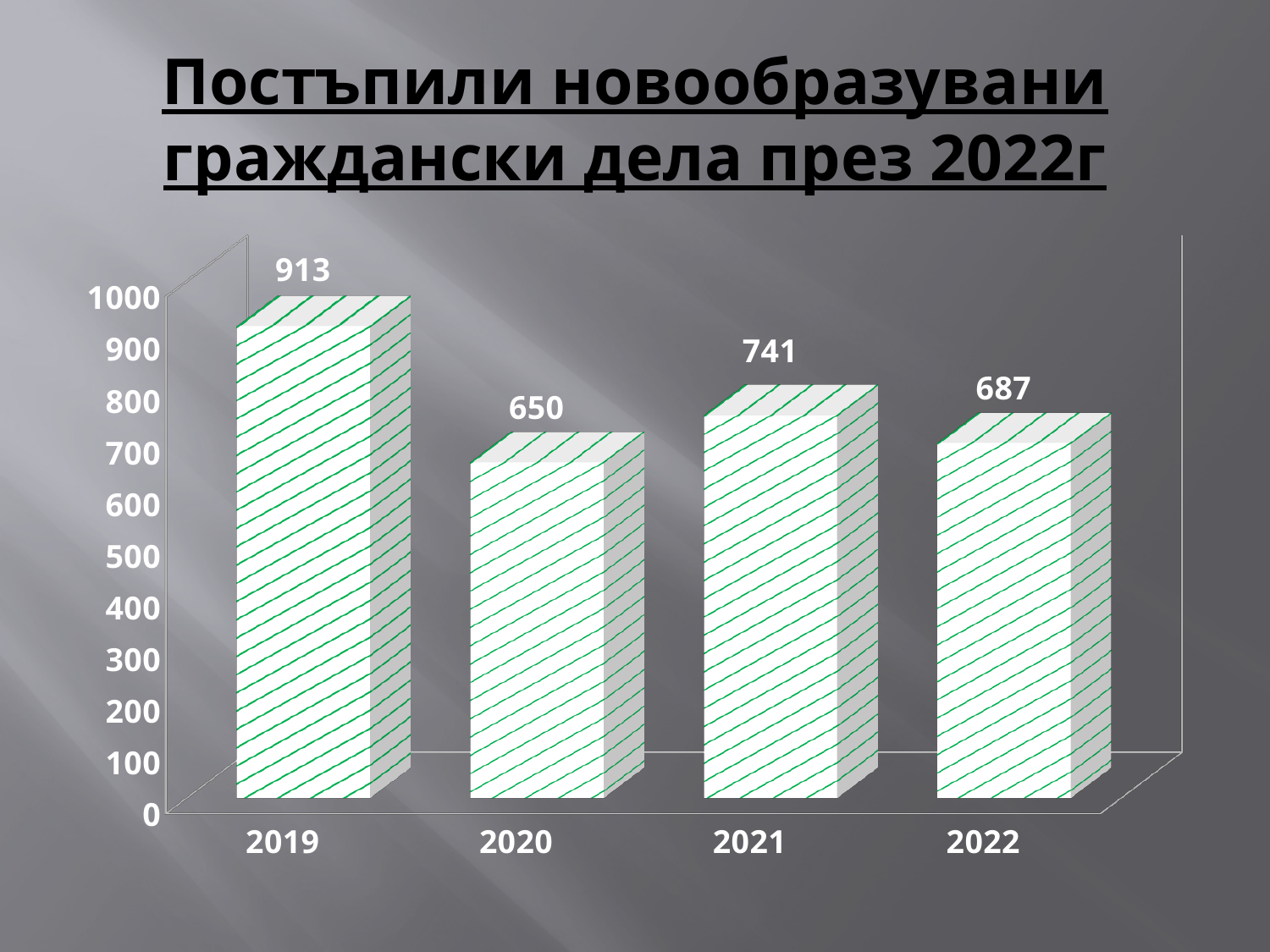
How many years are shown on the x axis? 4 What is the value for 2020? 650 What is the difference between the values for 2019 and 2020? 263 Which year has the highest value? 2019 What is the value for 2019? 913 What is the value for 2022? 687 Which is larger, the value for 2021 or the value for 2022? 2021 What is the difference between the values for 2021 and 2022? 54 What kind of chart is shown on the slide? bar chart Which year has the lowest value? 2020 What is the title of the chart on the slide? Постъпили новообразувани граждански дела през 2022г What is the value for 2021? 741